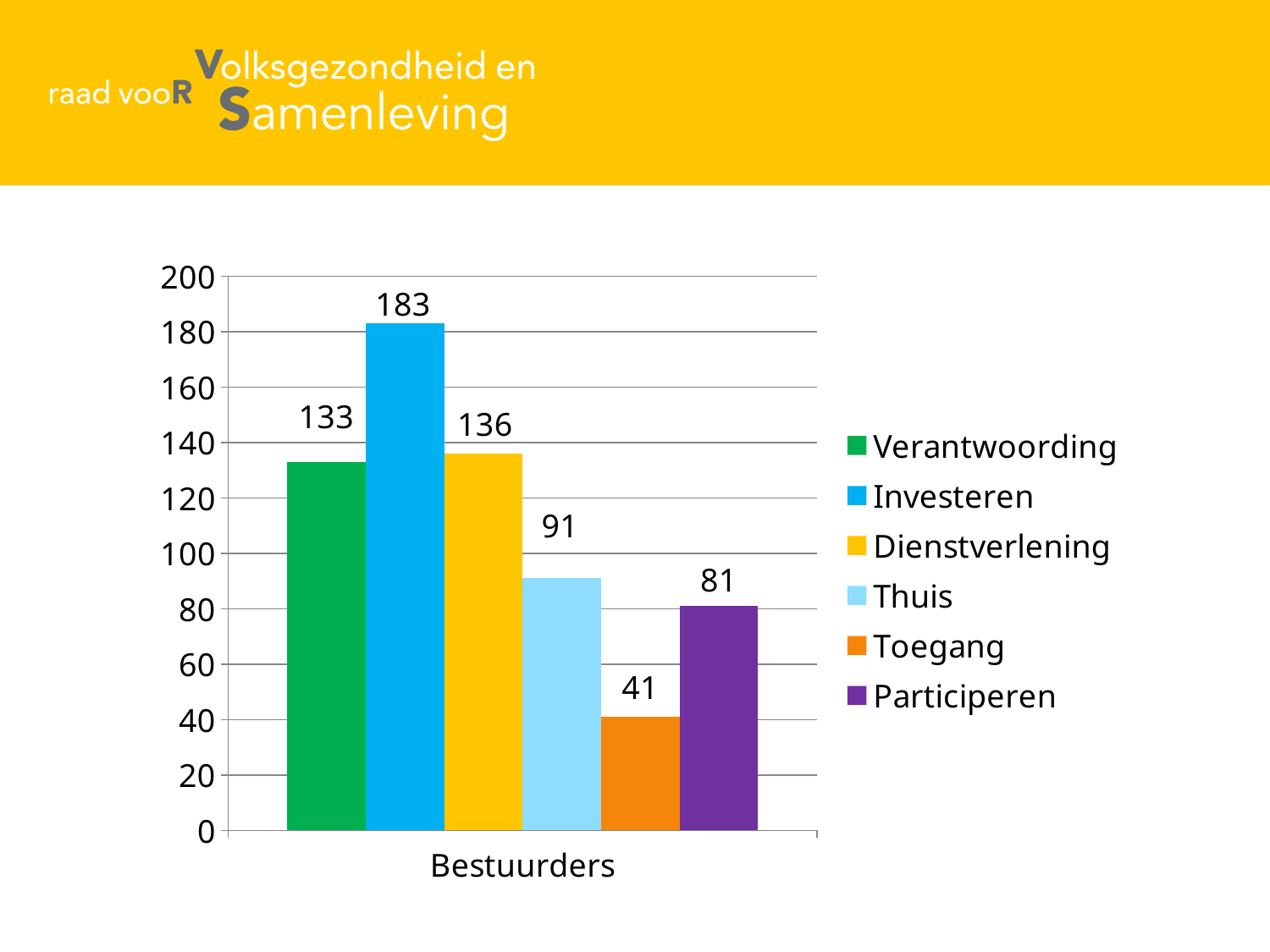
Which is larger, the value for Verantwoording or the value for Dienstverlening? Dienstverlening What is the value for Investeren in the Bestuurders chart? 183 What is the value for Thuis in the Bestuurders chart? 91 Which series has the lowest value in the Bestuurders chart? Toegang Which series has the highest value in the Bestuurders chart? Investeren What is the difference between the values for Thuis and Participeren? 10 What is the difference between the values for Investeren and Dienstverlening? 47 Is the value for Participeren greater or less than 100? less What is the label on the x axis of the chart? Bestuurders What kind of chart is shown on the slide? bar chart How many series does the legend list? 6 What is the value for Toegang in the Bestuurders chart? 41